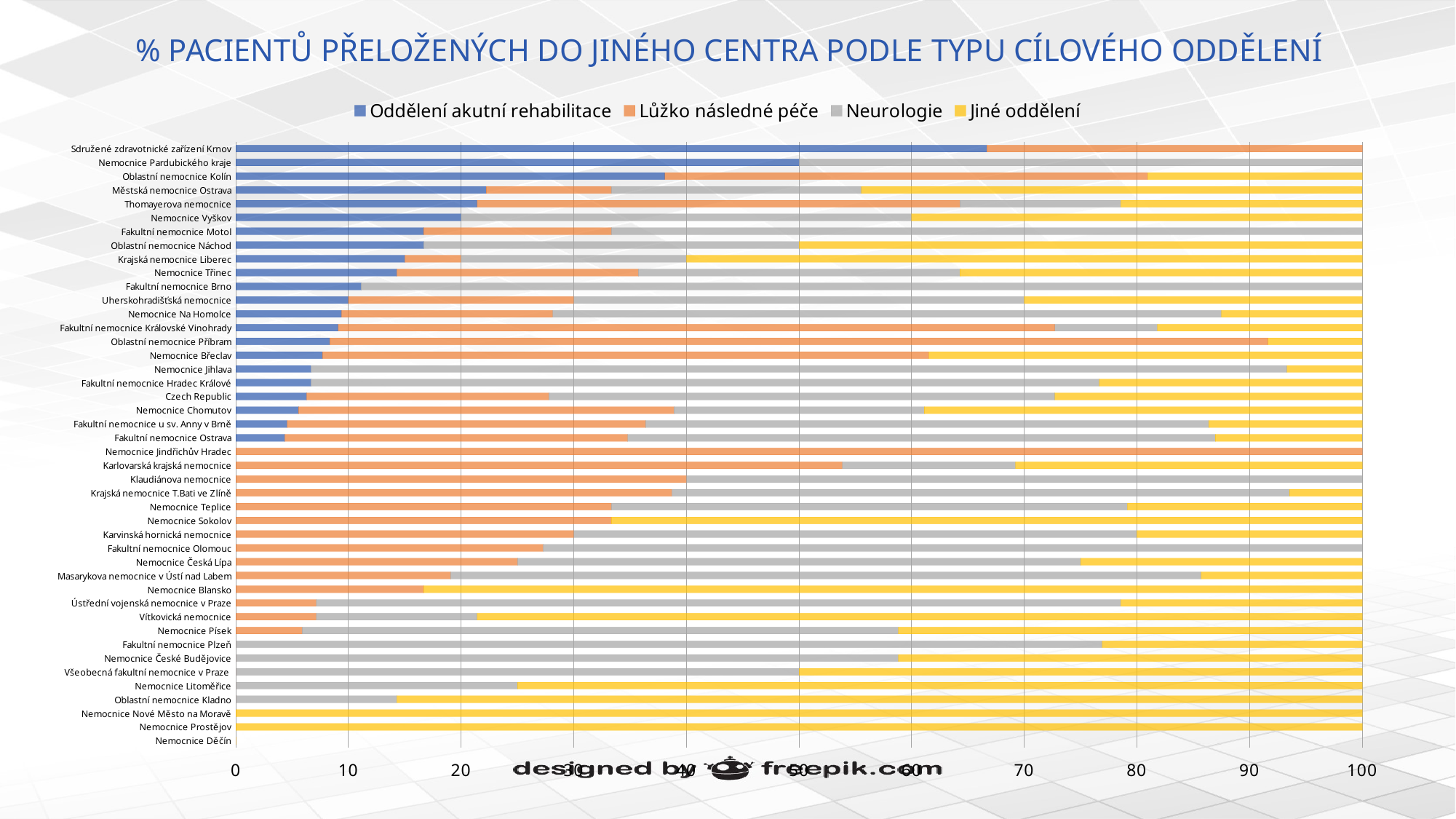
How many hospitals (categories) are listed on the vertical axis? 44 What is the value for Jiné oddělení at Nemocnice Prostějov? 100 Which hospital has the highest share for Oddělení akutní rehabilitace? Sdružené zdravotnické zařízení Krnov Which has a larger value for Oddělení akutní rehabilitace: Oblastní nemocnice Kolín or Městská nemocnice Ostrava? Oblastní nemocnice Kolín Is the value for Oddělení akutní rehabilitace at Sdružené zdravotnické zařízení Krnov greater or less than 60? greater What is the value for Oddělení akutní rehabilitace at Nemocnice Vyškov? 20 How many series does the legend list? 4 What is the value for Oddělení akutní rehabilitace at Nemocnice Pardubického kraje? 50 Is the value for Oddělení akutní rehabilitace at Fakultní nemocnice Ostrava greater or less than 10? less What kind of chart is shown on the slide? bar chart Which series is shown in yellow in the legend? Jiné oddělení What is the title of the chart? % PACIENTŮ PŘELOŽENÝCH DO JINÉHO CENTRA PODLE TYPU CÍLOVÉHO ODDĚLENÍ